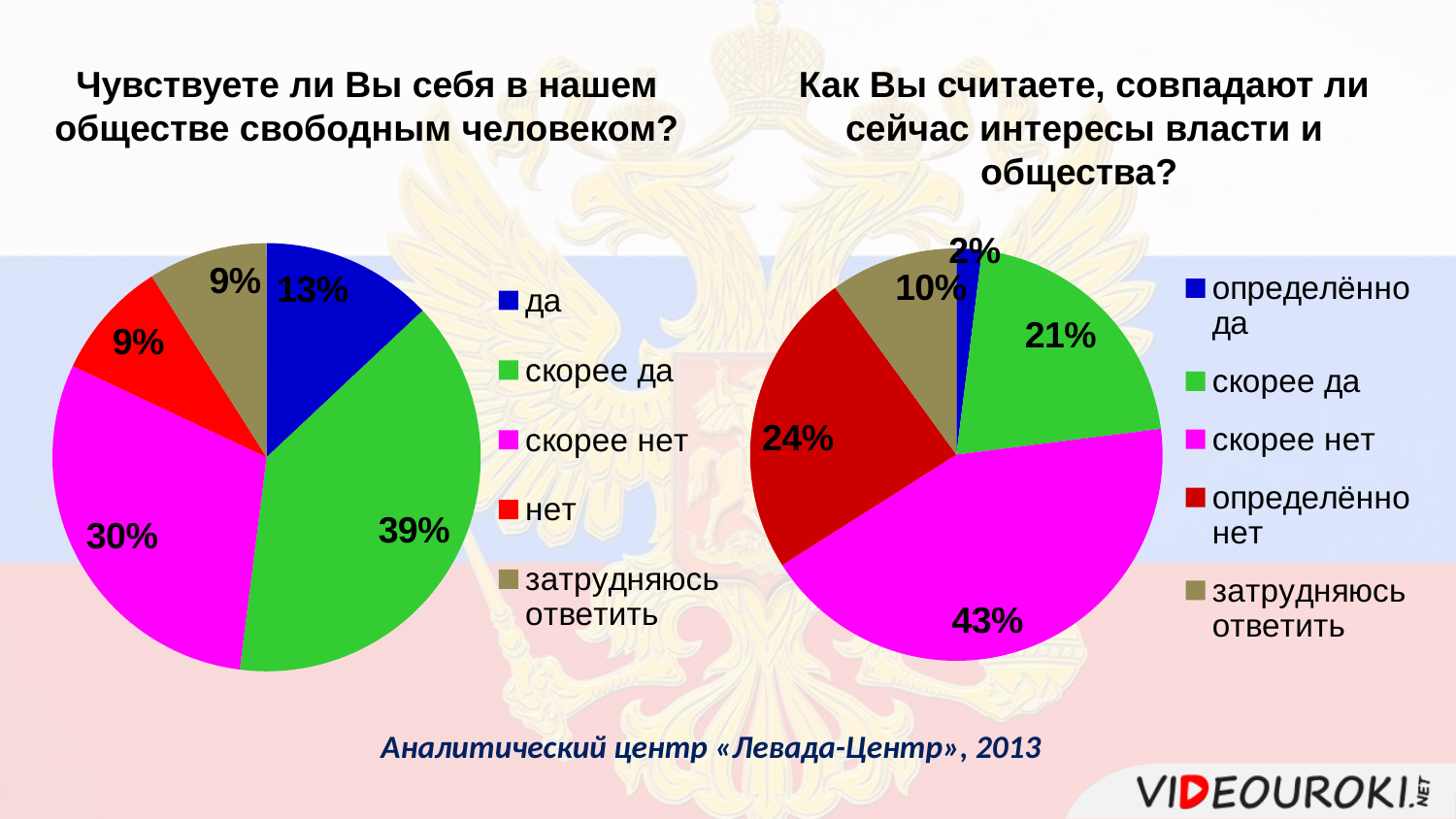
How many categories does the legend of the left pie chart list? 5 In the left pie chart ("Чувствуете ли Вы себя в нашем обществе свободным человеком?"), what share is labelled for "скорее да"? 39% In the left pie chart, what is the difference between the shares for "скорее да" and "скорее нет"? 9% In the right pie chart, which category has the smallest slice? определённо да In the right pie chart ("Как Вы считаете, совпадают ли сейчас интересы власти и общества?"), what share is labelled for "скорее нет"? 43% In the right pie chart, which is larger: the share for "скорее да" or the share for "затрудняюсь ответить"? скорее да What type of chart is used on the left side of the slide? pie chart What colour is the "скорее нет" slice in the right pie chart? magenta In the right pie chart, what share is labelled for "определённо нет"? 24% In the left pie chart, which category has the largest slice? скорее да In the left pie chart, what share is labelled for "да"? 13% In the right pie chart, what is the difference between the shares for "скорее нет" and "определённо нет"? 19%